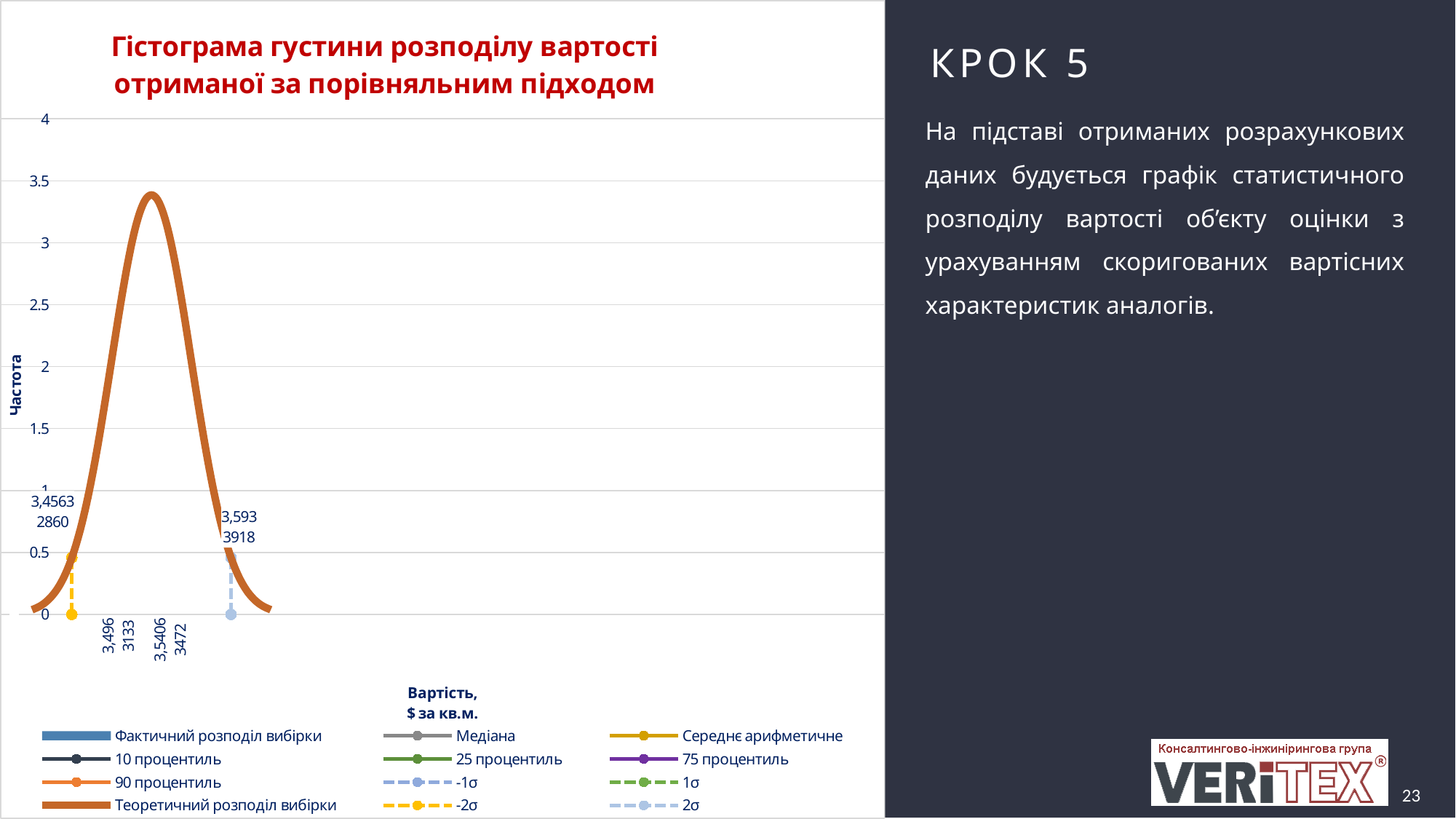
What data label is printed next to the yellow dashed vertical line on the left side of the curve? 3,4563 2860 What is the highest tick value shown on the vertical axis of the chart? 4 What is the label of the vertical axis of the chart? Частота What is the lowest tick value shown on the vertical axis of the chart? 0 What is the title of the chart on the slide? Гістограма густини розподілу вартості отриманої за порівняльним підходом What kind of chart is shown on the slide? line chart Does the theoretical distribution curve rise or fall after its peak as the x axis increases? fall Is the peak value of the theoretical distribution curve greater or less than 4? less Which legend entry is drawn as a yellow dashed line? -2σ How many series does the chart's legend list? 12 Is the peak value of the theoretical distribution curve (Теоретичний розподіл вибірки) greater or less than 3? greater What data label is printed next to the light blue dashed vertical line on the right side of the curve? 3,593 3918